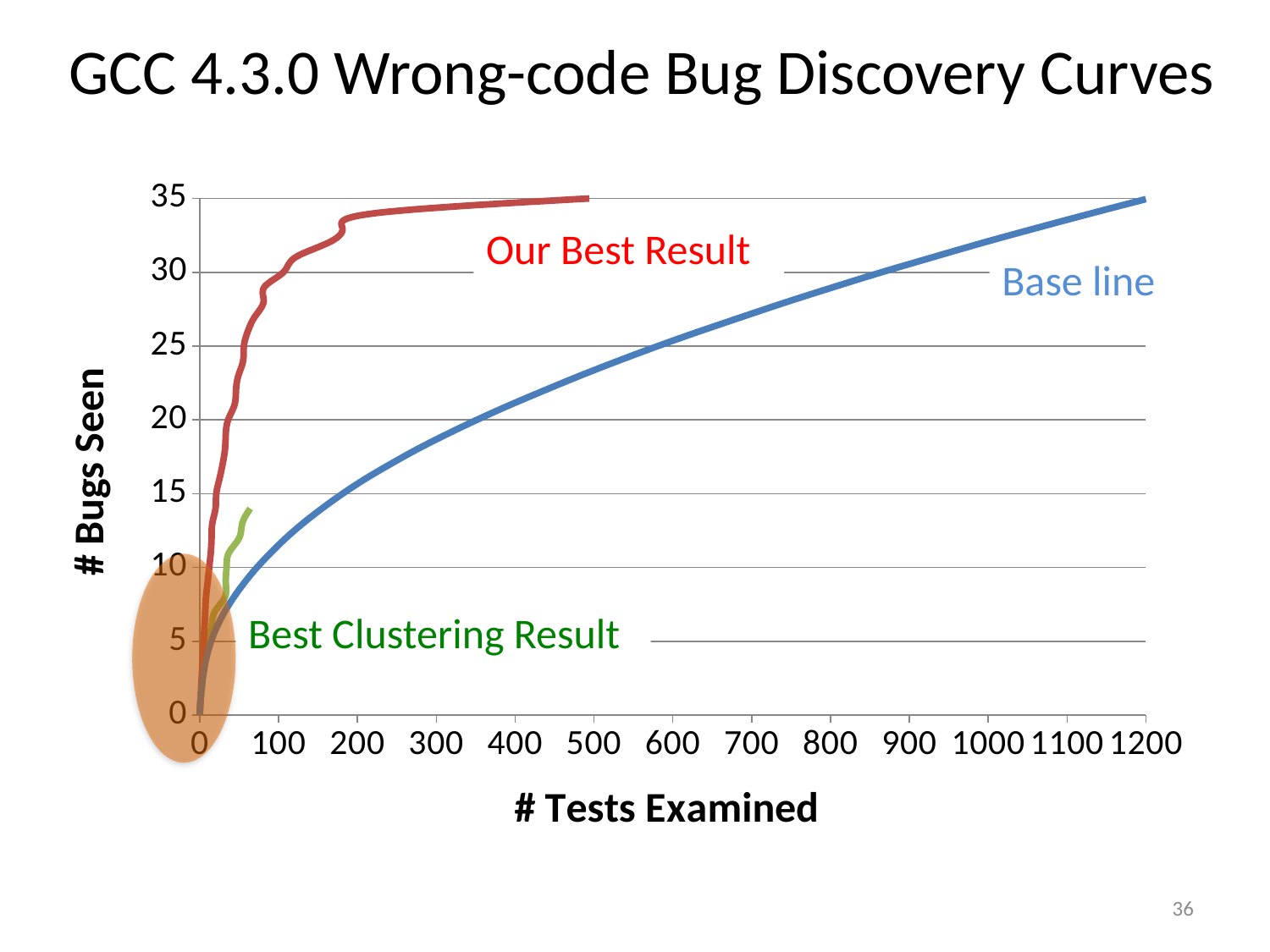
What kind of chart is shown on the slide? line chart Is the Best Clustering Result curve's highest value greater or less than 15 bugs seen? less How many curves are plotted on the chart? 3 At 300 tests examined, which curve shows more bugs seen: Our Best Result or Base line? Our Best Result Is the Our Best Result value at 100 tests examined greater or less than 25 bugs seen? greater Which curve extends to the largest number of tests examined? Base line Do the curves rise or fall as the number of tests examined increases? rise Is the Base line value at 800 tests examined greater or less than 30 bugs seen? less What is the title of the chart? GCC 4.3.0 Wrong-code Bug Discovery Curves What is the label of the y axis? # Bugs Seen Which curve reaches 30 bugs seen with the fewest tests examined? Our Best Result